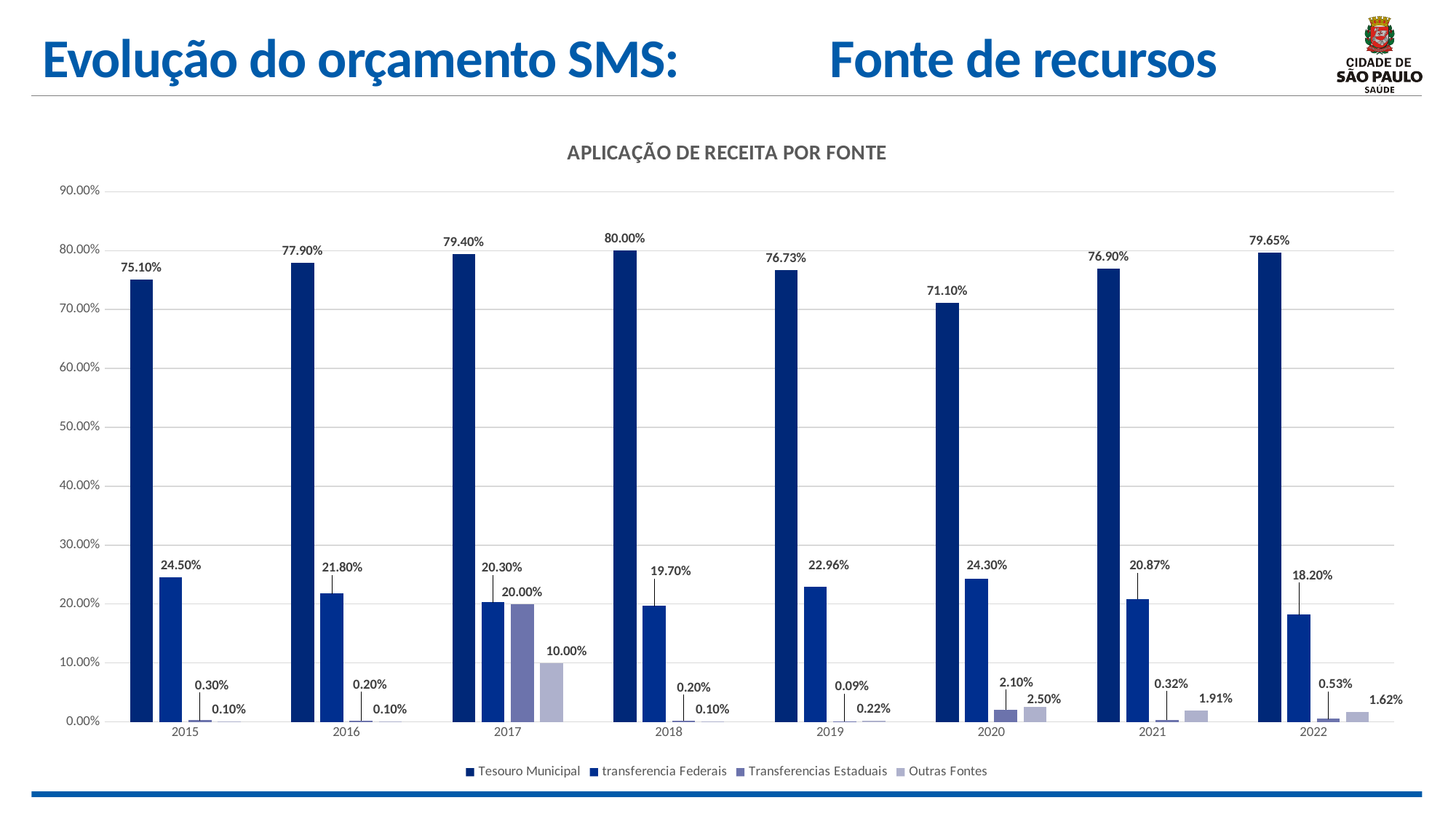
What is the value for transferencia Federais in 2019? 22.96% What kind of chart is shown on the slide? Bar chart What is the value for Tesouro Municipal in 2018? 80.00% Which is larger, the transferencia Federais value in 2015 or in 2022? 2015 What is the value for Outras Fontes in 2021? 1.91% In which year is the Tesouro Municipal value the lowest? 2020 How many years are shown on the x axis? 8 What is the difference between the Tesouro Municipal values in 2022 and 2020? 8.55% How many series does the legend list? 4 What is the value for Transferencias Estaduais in 2017? 20.00% Is the Tesouro Municipal value for 2016 greater or less than 70.00%? greater In which year is the Tesouro Municipal value the highest? 2018